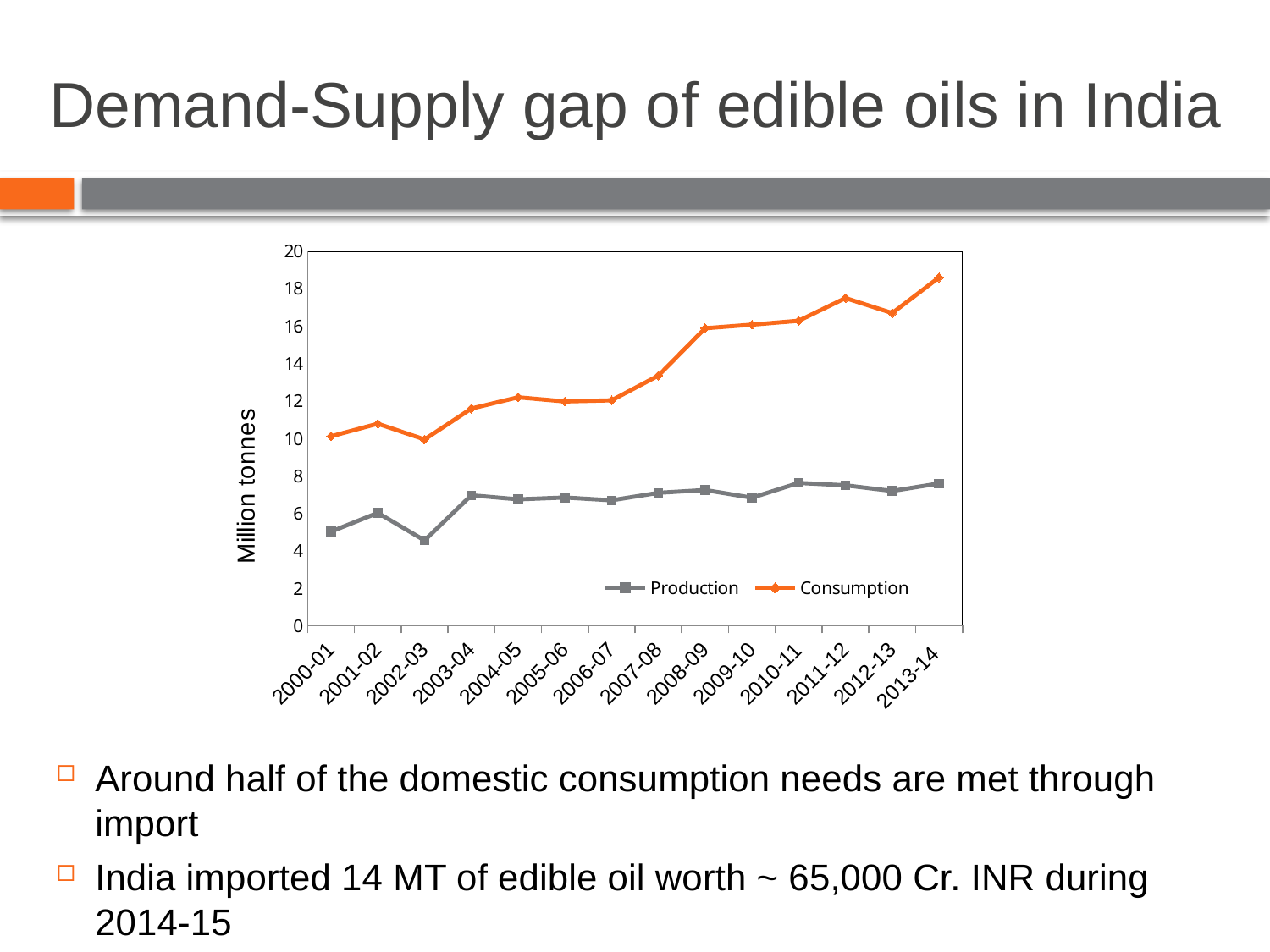
How many series does the legend list? 2 How many years are plotted along the x axis? 14 What kind of chart is shown on the slide? Line chart Which series is plotted in orange? Consumption Does Consumption generally rise or fall from 2000-01 to 2013-14? rise What is the label on the vertical axis? Million tonnes In which year is Consumption highest? 2013-14 Is the Production value for 2002-03 greater or less than 6? less Which is larger in 2013-14, Production or Consumption? Consumption Is the Consumption value for 2013-14 greater or less than 18? greater In which year is Production lowest? 2002-03 Is the Consumption value for 2007-08 greater or less than 14? less